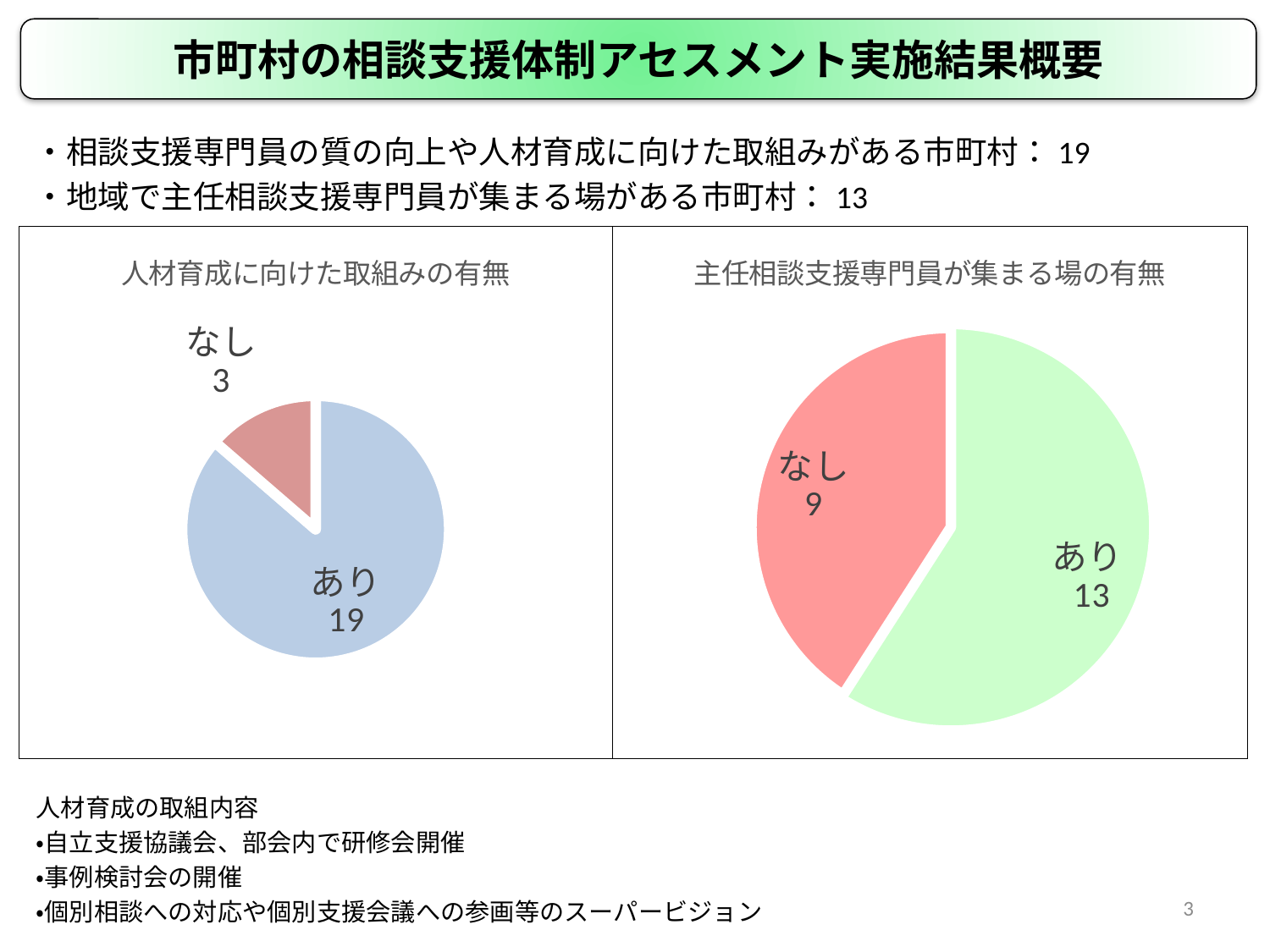
Which is larger: あり in the left pie chart or あり in the right pie chart? あり in the left pie chart In the left pie chart (人材育成に向けた取組みの有無), what is the difference between あり and なし? 16 In the right pie chart (主任相談支援専門員が集まる場の有無), what is the value for なし? 9 What kind of chart is the left chart (人材育成に向けた取組みの有無)? Pie chart In the left pie chart (人材育成に向けた取組みの有無), what is the value for あり? 19 What is the title of the right chart? 主任相談支援専門員が集まる場の有無 How many slices does the right pie chart (主任相談支援専門員が集まる場の有無) have? 2 In the left pie chart (人材育成に向けた取組みの有無), what is the value for なし? 3 In the left pie chart (人材育成に向けた取組みの有無), which category is the largest? あり In the right pie chart (主任相談支援専門員が集まる場の有無), which category is the smallest? なし In the right pie chart (主任相談支援専門員が集まる場の有無), what is the value for あり? 13 In the right pie chart (主任相談支援専門員が集まる場の有無), what is the difference between あり and なし? 4